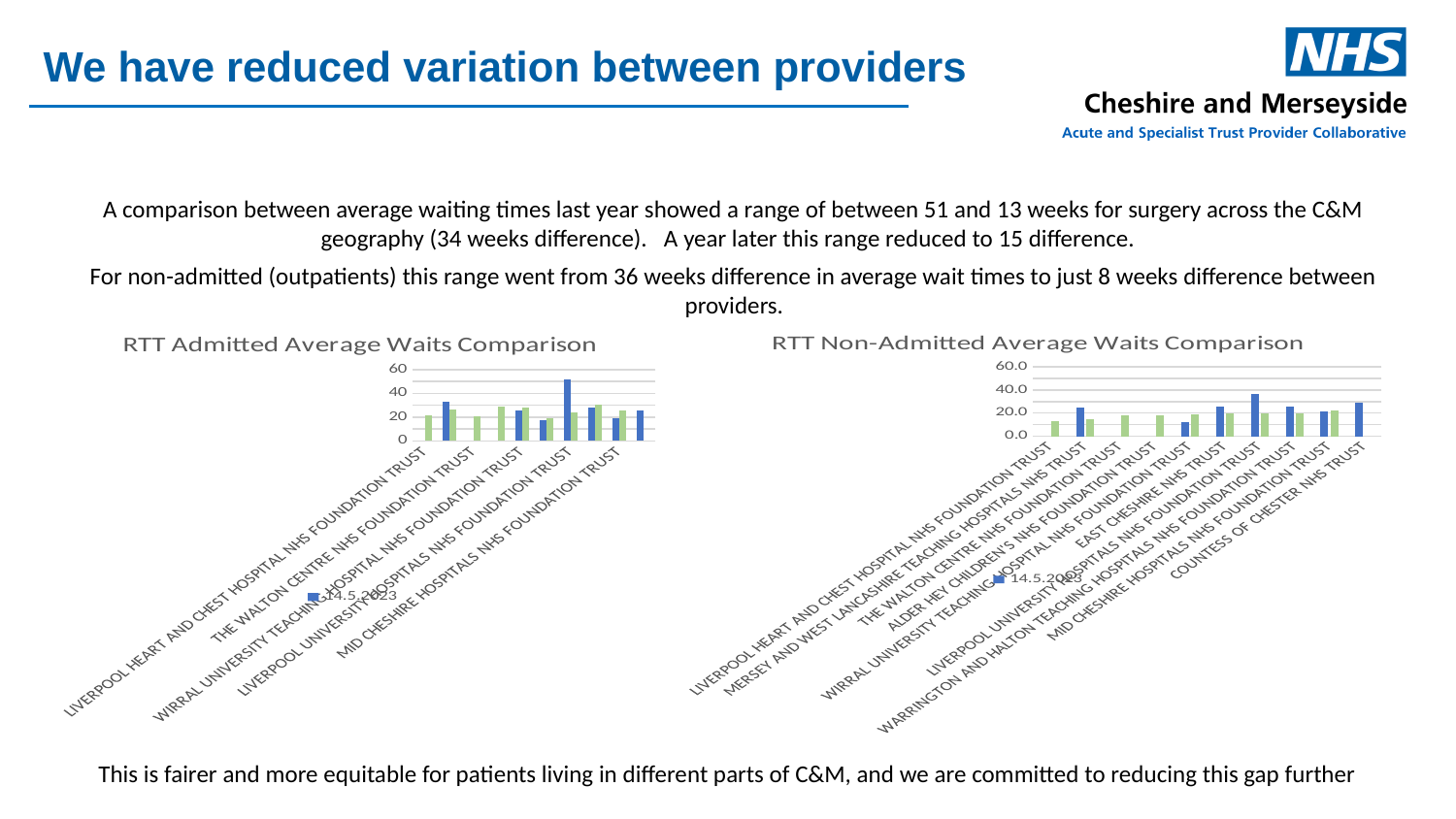
How many bar colours (series) are plotted in the RTT Non-Admitted Average Waits Comparison chart? 2 What is the highest value shown on the vertical axis of the RTT Admitted Average Waits Comparison chart? 60 What is the title of the chart on the right of the slide? RTT Non-Admitted Average Waits Comparison In the RTT Admitted Average Waits Comparison chart, is the tallest bar greater or less than 40? greater What kind of chart is the RTT Admitted Average Waits Comparison chart? Bar chart What is the title of the chart on the left of the slide? RTT Admitted Average Waits Comparison In the RTT Non-Admitted Average Waits Comparison chart, is the tallest bar greater or less than 20? greater What kind of chart is the RTT Non-Admitted Average Waits Comparison chart? Bar chart In the RTT Admitted Average Waits Comparison chart, is the tallest bar greater or less than 60? less